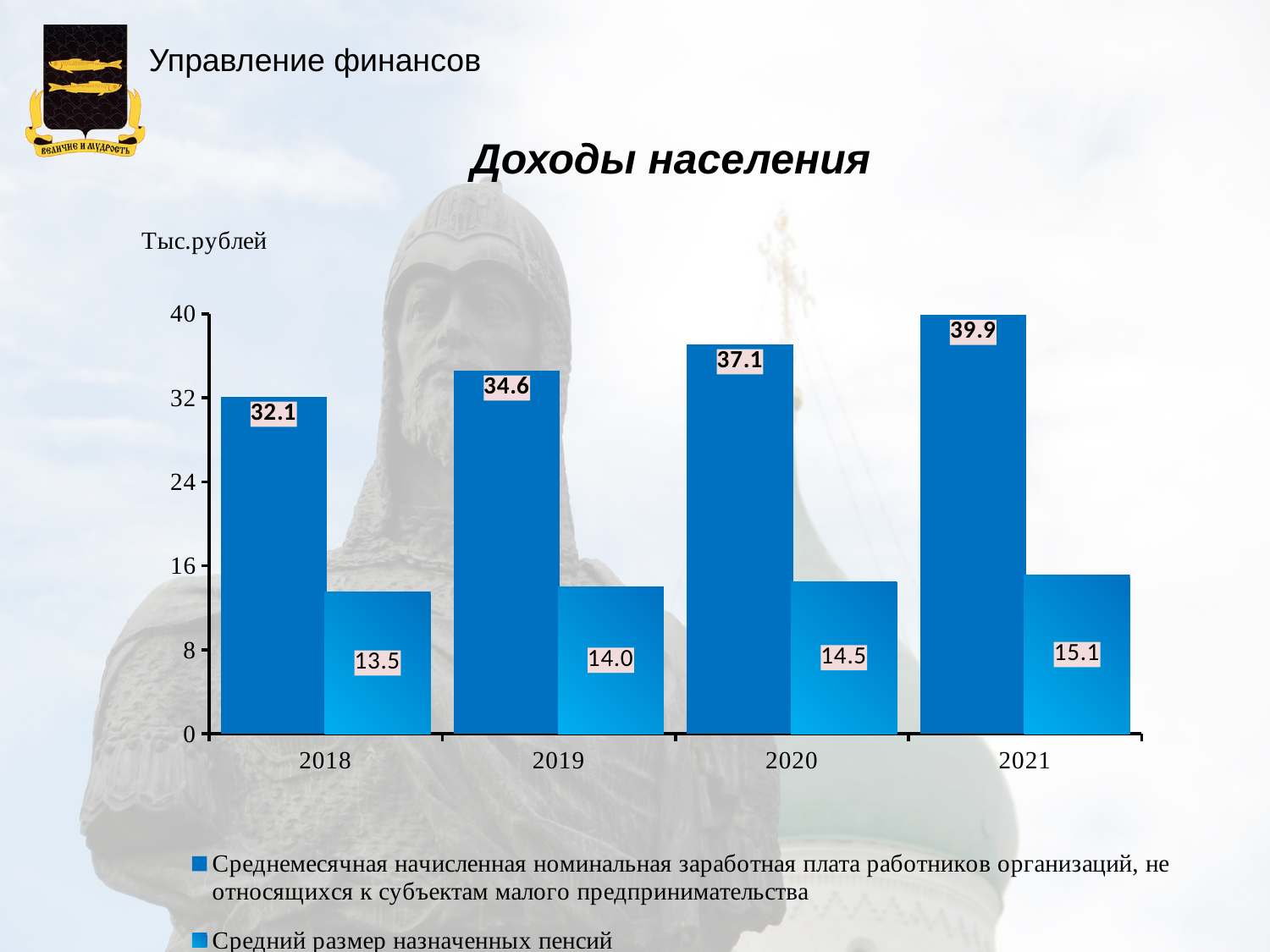
In which year is the average monthly nominal wage the highest? 2021 What kind of chart is shown on the slide? Bar chart What is the difference between the average monthly nominal wage in 2021 and in 2018? 7.8 What is the average monthly nominal wage value for 2021? 39.9 What is the difference between the average monthly nominal wage and the average pension in 2020? 22.6 In which year is the average pension the lowest? 2018 How many years are shown on the x axis? 4 Does the average monthly nominal wage rise or fall from 2018 to 2021? Rise How many series does the legend list? 2 What is the average pension (Средний размер назначенных пенсий) value for 2020? 14.5 Which is larger: the average pension in 2021 or the average pension in 2019? 2021 What is the average monthly nominal wage (Среднемесячная начисленная номинальная заработная плата) value for 2019? 34.6